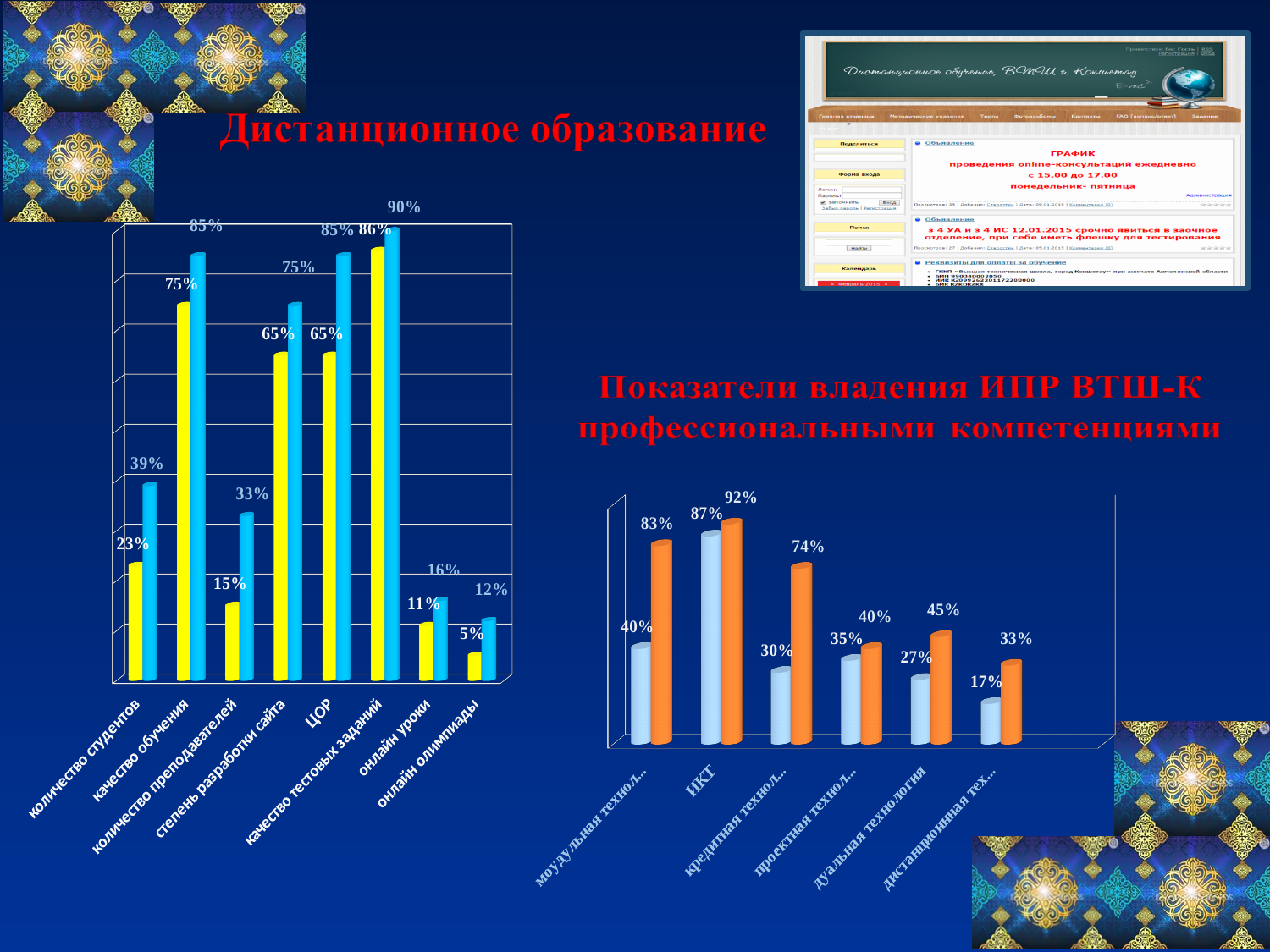
What type of chart is the right chart (Показатели владения ИПР ВТШ-К профессиональными компетенциями)? bar chart In the left chart (Дистанционное образование), how many categories are shown on the x axis? 8 In the right chart (Показатели владения ИПР ВТШ-К профессиональными компетенциями), which category has the highest light blue bar? ИКТ In the left chart (Дистанционное образование), which category has the lowest yellow bar? онлайн олимпиады In the right chart (Показатели владения ИПР ВТШ-К профессиональными компетенциями), what is the value of the light blue bar for дистанционная тех...? 17% In the left chart (Дистанционное образование), what is the value of the yellow bar for количество студентов? 23% In the right chart (Показатели владения ИПР ВТШ-К профессиональными компетенциями), what is the value of the orange bar for ИКТ? 92% In the left chart (Дистанционное образование), what is the difference between the blue and yellow bars for количество преподавателей? 18% In the left chart (Дистанционное образование), which is larger: the blue bar for ЦОР or the blue bar for степень разработки сайта? ЦОР In the left chart (Дистанционное образование), what is the value of the blue bar for качество тестовых заданий? 90% In the right chart (Показатели владения ИПР ВТШ-К профессиональными компетенциями), how many categories are shown? 6 In the right chart (Показатели владения ИПР ВТШ-К профессиональными компетенциями), what is the difference between the orange and light blue bars for дуальная технология? 18%